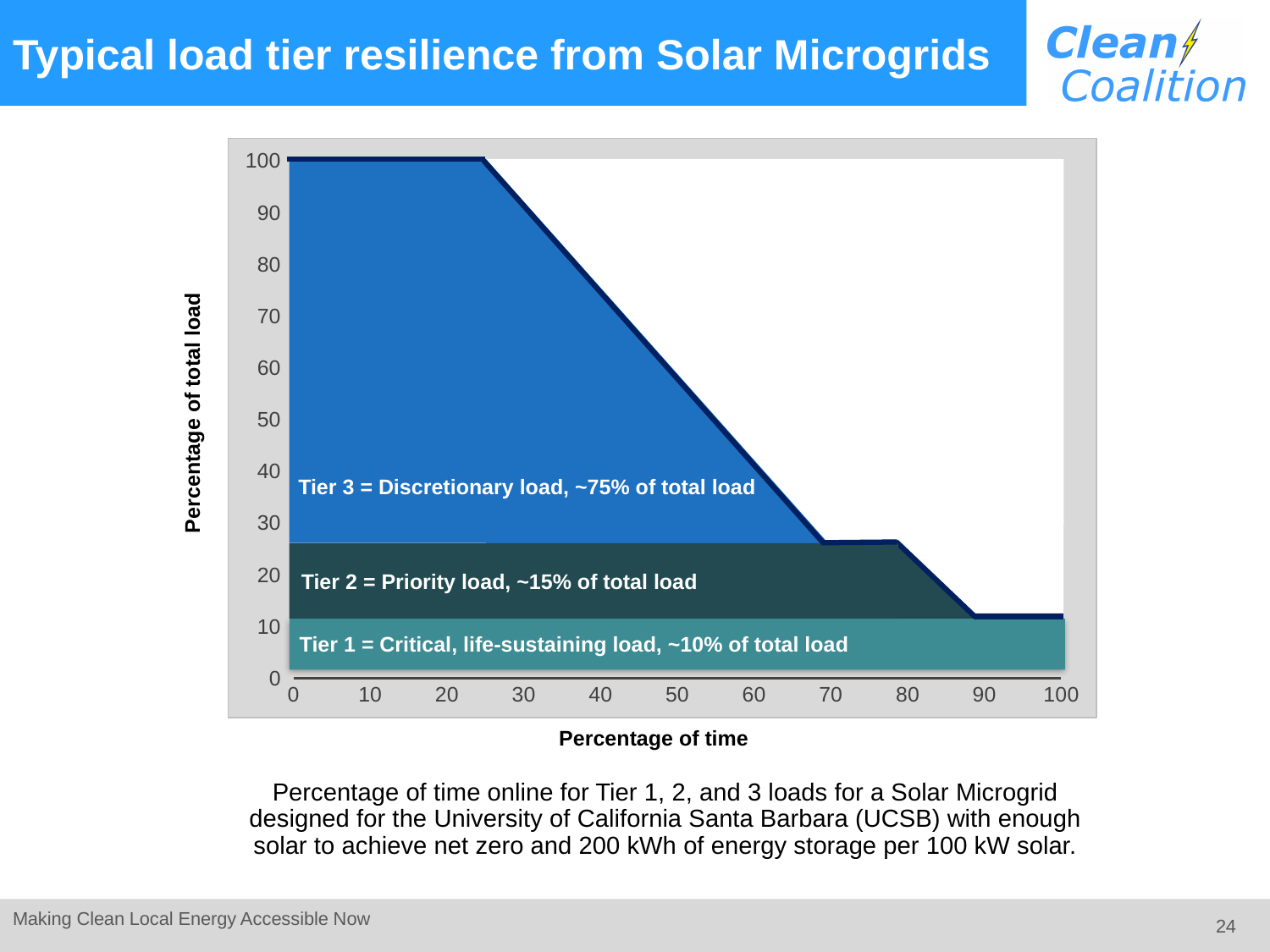
According to the label in the chart, what share of total load is Tier 2 (Priority load)? ~15% Does the percentage of total load rise or fall as the percentage of time increases? fall What kind of chart is shown on the slide? area chart What is the title of the chart's x axis? Percentage of time According to the label in the chart, what share of total load is Tier 3 (Discretionary load)? ~75% How many load tiers are labelled in the chart? 3 What is the percentage of total load at 0% of time? 100 According to the label in the chart, what share of total load is Tier 1 (Critical, life-sustaining load)? ~10% What is the title of the chart's y axis? Percentage of total load Is the percentage of total load at 95% of time greater or less than 20? less Is the percentage of total load at 40% of time greater or less than 60? greater Is the percentage of total load at 60% of time greater or less than 50? less